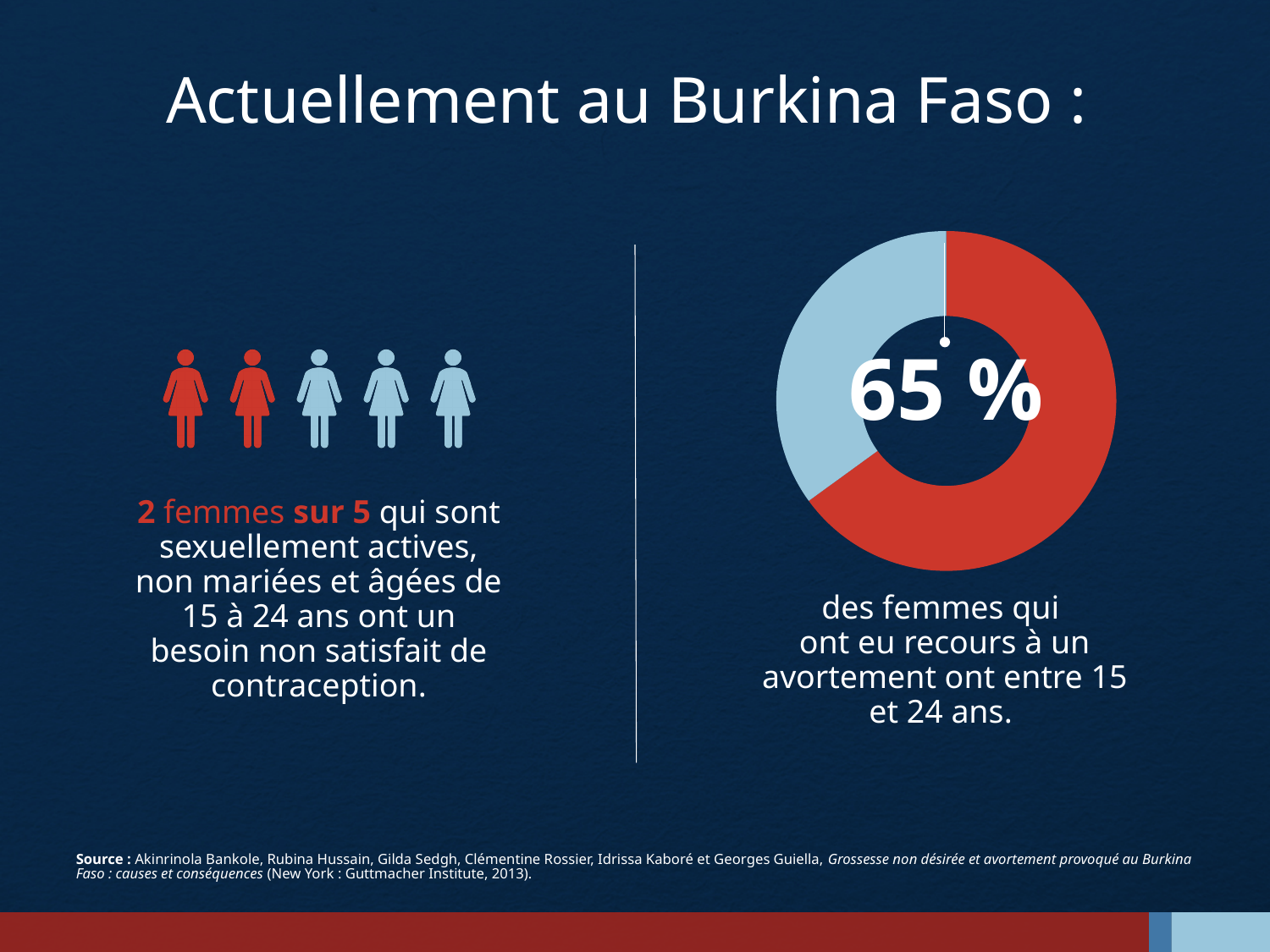
In the donut chart, what share of women who had an abortion are aged 15 to 24? 65 % What kind of chart is shown on the right side of the slide? Donut (pie) chart What percentage does the light blue slice of the donut chart represent? 35 % In the pictogram on the left, how many of the woman figures are red? 2 In the donut chart, which slice is larger, the red one or the light blue one? The red one In the pictogram on the left, how many of the woman figures are light blue? 3 Is the value shown in the donut chart greater or less than 50 %? greater What percentage is printed in the centre of the donut chart? 65 % According to the pictogram on the left, how many women out of 5 have an unmet need for contraception? 2 sur 5 What colour is the 65 % slice of the donut chart? Red How many slices does the donut chart have? 2 How many woman figures are shown in the pictogram on the left of the slide? 5